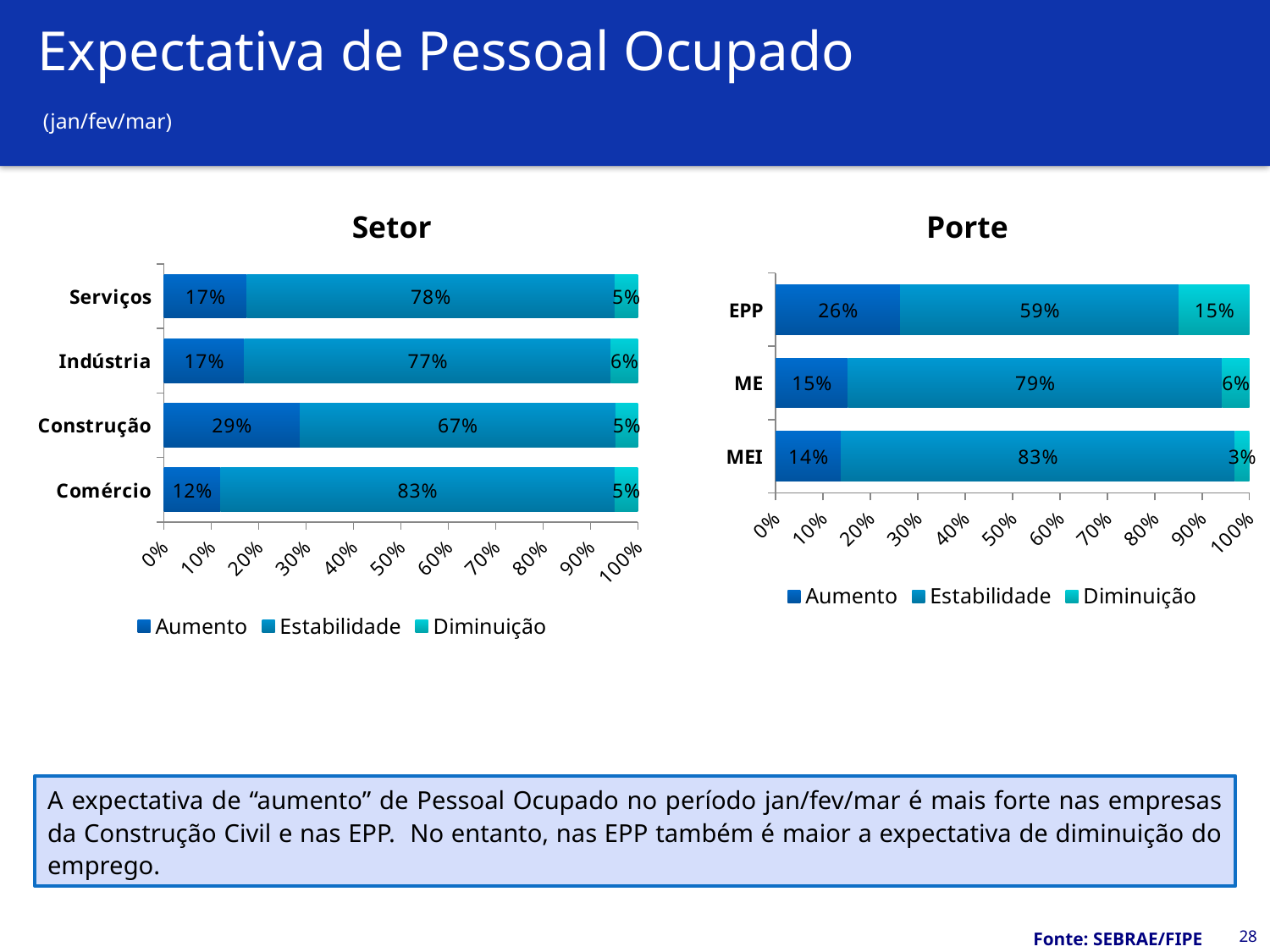
In the 'Porte' chart, what is the difference between the 'Aumento' values for EPP and ME? 11% In the 'Porte' chart, what is the 'Estabilidade' value for MEI? 83% In the 'Porte' chart, which category has the lowest 'Diminuição' value? MEI In the 'Setor' chart, what is the 'Estabilidade' value for Comércio? 83% In the 'Setor' chart, what is the total of the stacked bar for Indústria? 100% How many series does the legend of the 'Porte' chart list? 3 In the 'Setor' chart, which is larger: the 'Estabilidade' value for Serviços or for Construção? Serviços In the 'Setor' chart, what is the 'Aumento' value for Construção? 29% In the 'Setor' chart, which category has the highest 'Aumento' value? Construção In the 'Porte' chart, what is the 'Diminuição' value for EPP? 15% How many categories are shown in the 'Setor' chart? 4 What kind of chart is the 'Porte' chart? Stacked bar chart